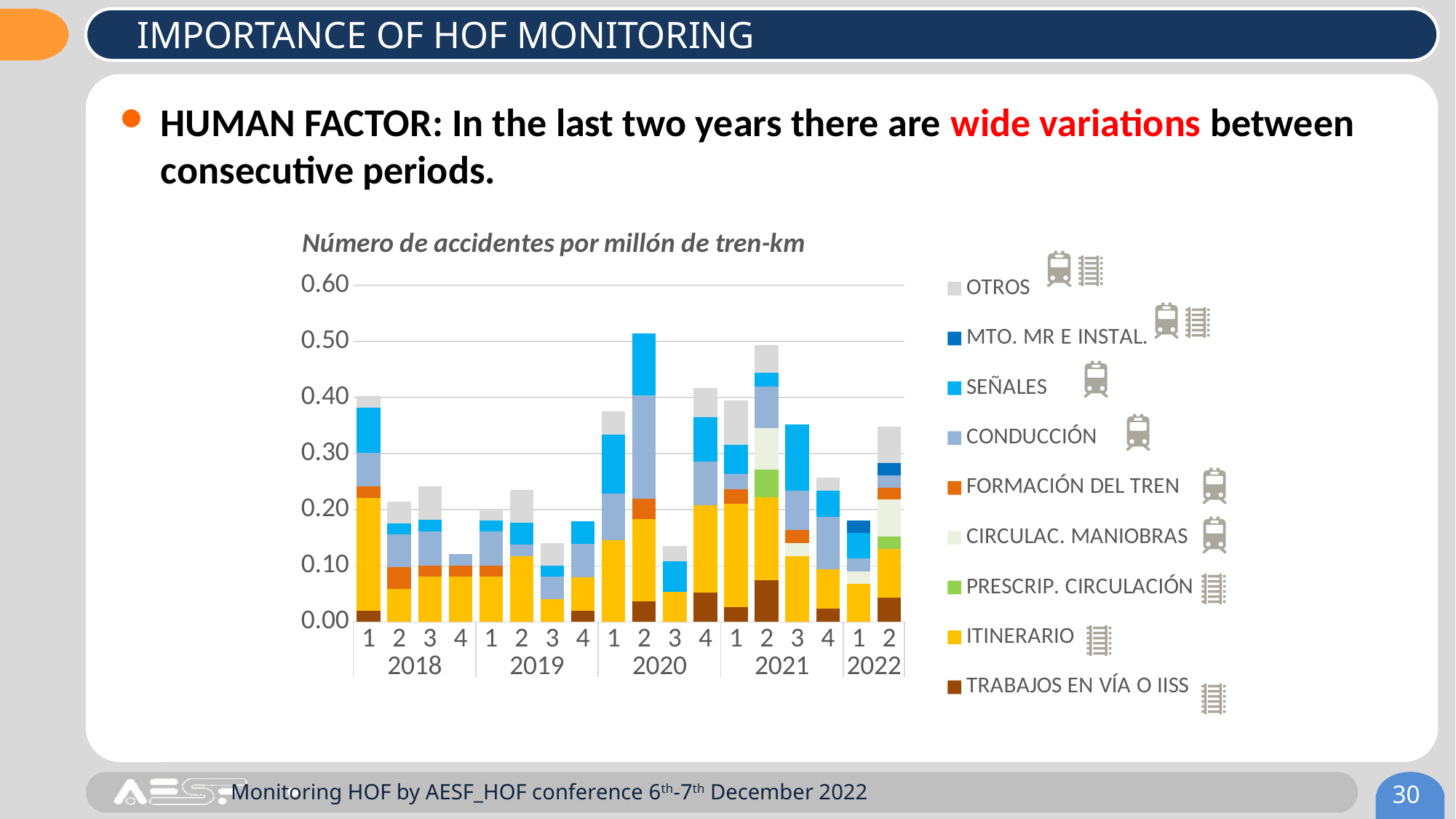
What kind of chart is shown on the slide? Stacked bar chart What is the title of the chart? Número de accidentes por millón de tren-km Is the total value for 2021 period 2 greater or less than 0.40? greater Is the total value for 2022 period 1 greater or less than 0.30? less Which series is shown in yellow in the legend? ITINERARIO Which has the larger total, 2020 period 2 or 2020 period 3? 2020 period 2 Is the total value for 2018 period 4 greater or less than 0.20? less Which has the larger total, 2021 period 2 or 2021 period 4? 2021 period 2 How many bars (periods) are plotted in the chart? 18 Which period has the tallest stacked bar in the chart? 2020 period 2 How many series does the chart legend list? 9